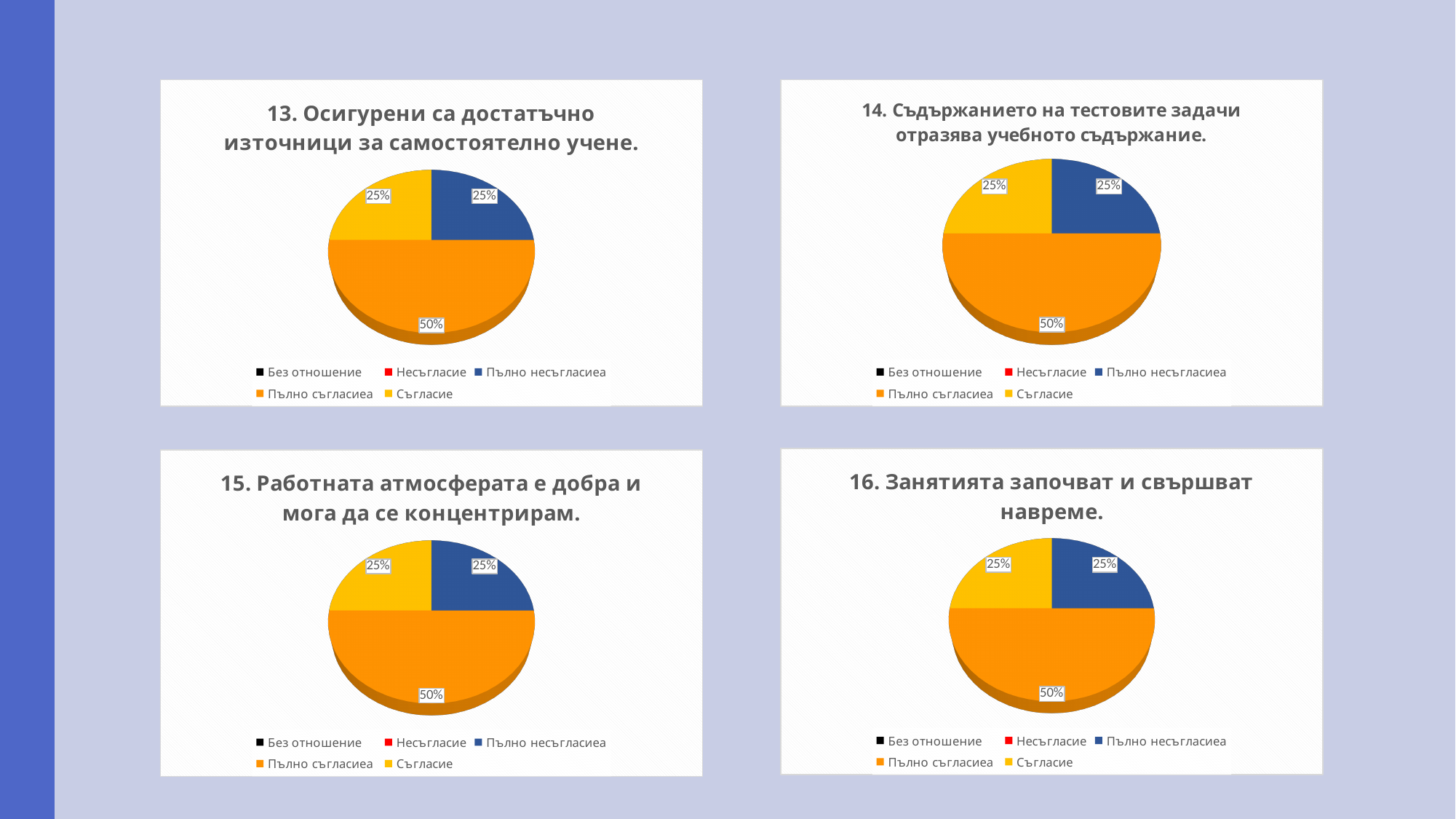
What type of chart is used for "14. Съдържанието на тестовите задачи отразява учебното съдържание."? Pie chart In the chart titled "13. Осигурени са достатъчно източници за самостоятелно учене.", what share does "Пълно съгласиеа" have? 50% In the chart titled "14. Съдържанието на тестовите задачи отразява учебното съдържание.", what share does "Пълно несъгласиеа" have? 25% In the bottom-left chart (15), what is the combined share of "Пълно несъгласиеа" and "Съгласие"? 50% In the top-left chart (13), what is the difference between the share for "Пълно съгласиеа" and the share for "Съгласие"? 25% In the bottom-right chart (16), which is larger: the slice for "Пълно съгласиеа" or the slice for "Пълно несъгласиеа"? Пълно съгласиеа In the top-right chart (14), how many slices with data labels are shown in the pie? 3 In the chart titled "13. Осигурени са достатъчно източници за самостоятелно учене.", what colour is the "Съгласие" slice? Yellow How many entries does the legend list in the chart titled "15. Работната атмосферата е добра и мога да се концентрирам."? 5 How many pie charts are shown on the slide? 4 In the chart titled "15. Работната атмосферата е добра и мога да се концентрирам.", what share does "Съгласие" have? 25% In the chart titled "16. Занятията започват и свършват навреме.", which category has the largest slice? Пълно съгласиеа